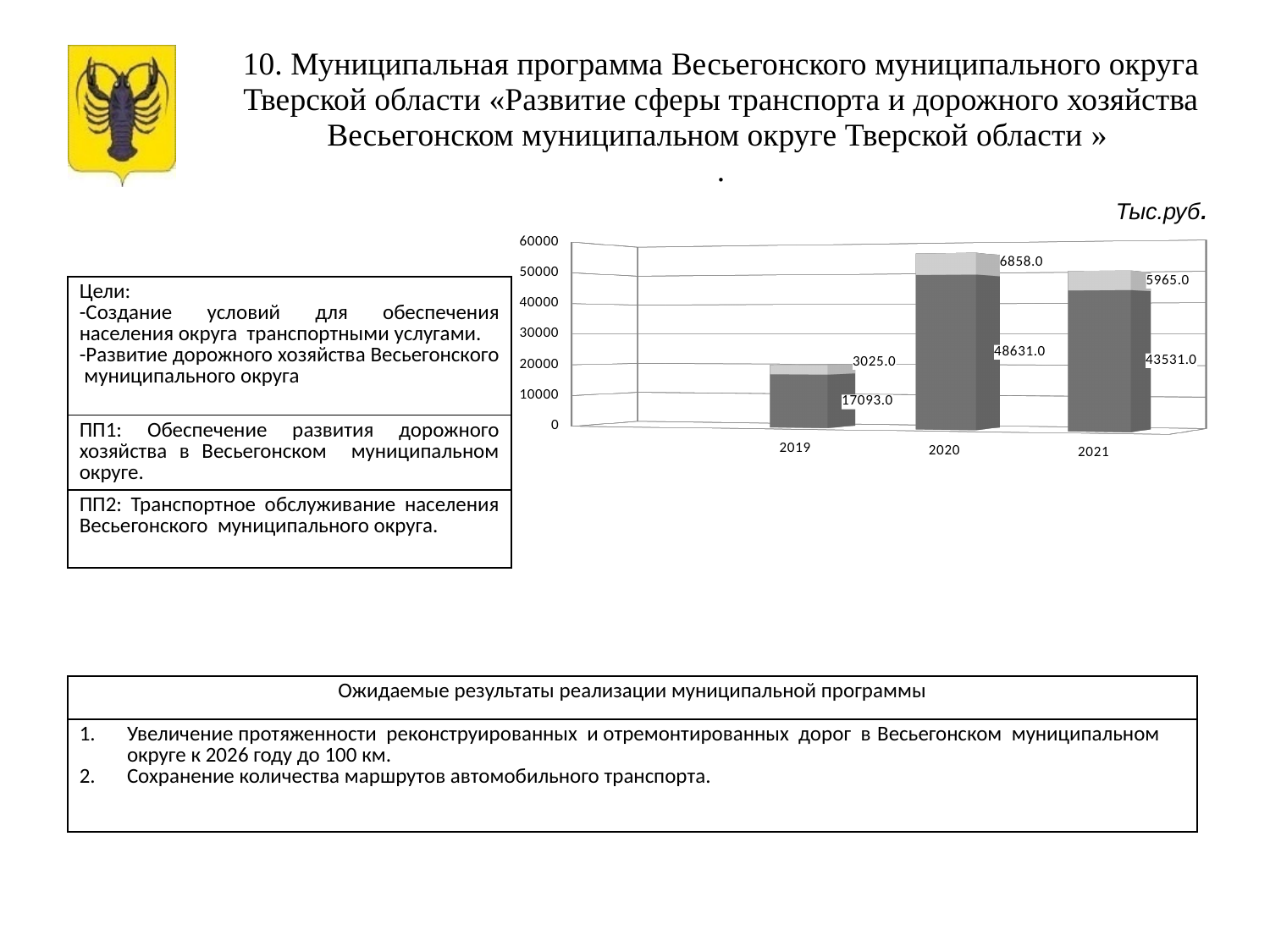
What is the total of the stacked bar for 2020? 55489.0 What is the difference between the dark grey segment values for 2020 and 2021? 5100.0 Which is larger: the light grey segment for 2020 or for 2021? 2020 What is the value of the dark grey (lower) segment for 2019? 17093.0 In which year is the light grey (upper) segment the lowest? 2019 What unit is indicated above the chart? Тыс.руб. What is the value of the dark grey (lower) segment for 2021? 43531.0 What is the value of the light grey (upper) segment for 2019? 3025.0 How many years are shown on the x axis of the chart? 3 What is the value of the light grey (upper) segment for 2020? 6858.0 In which year is the dark grey (lower) segment the highest? 2020 What kind of chart is shown on the slide? Stacked bar chart